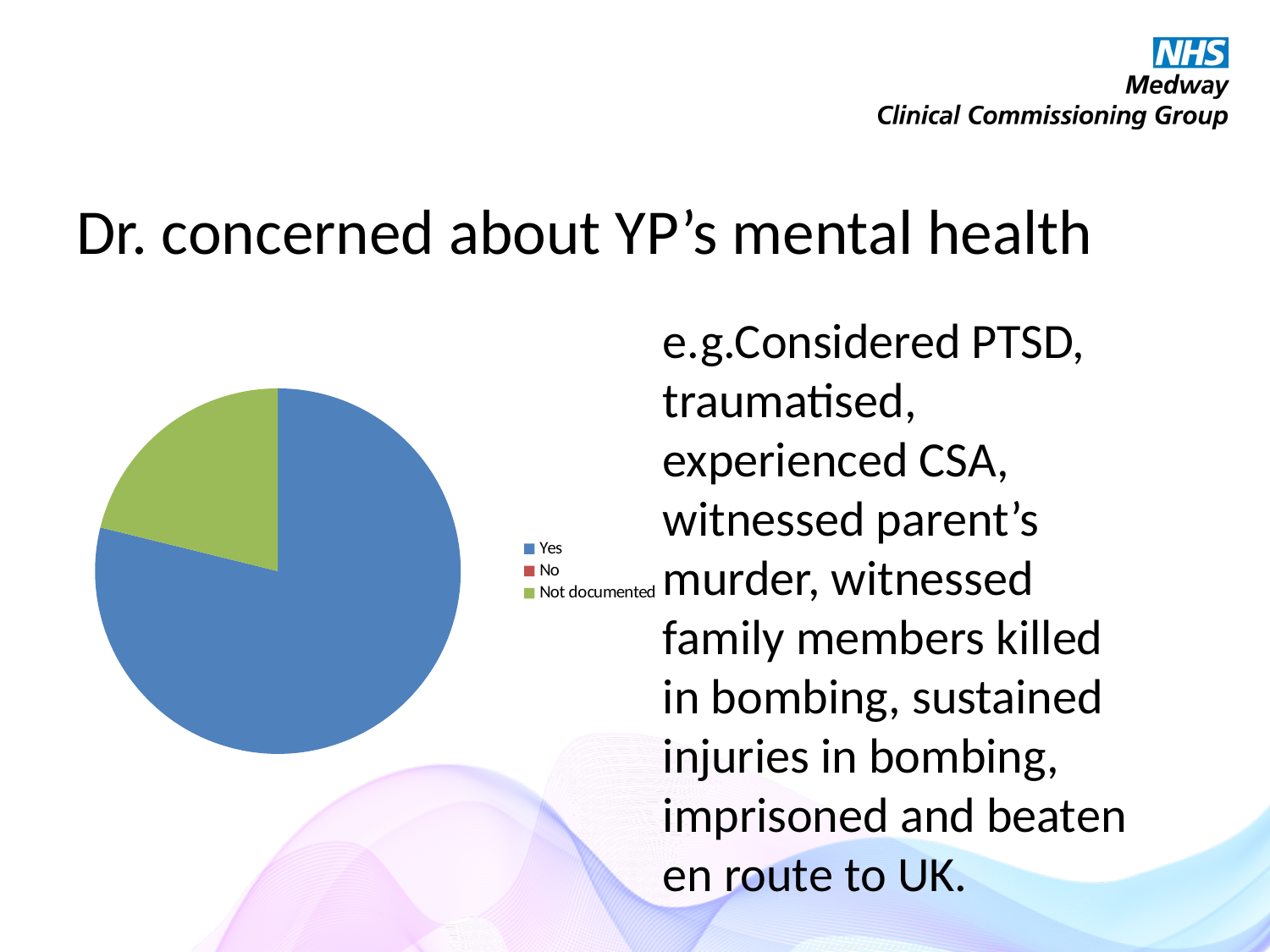
What are the legend entries of the pie chart? Yes, No, Not documented What kind of chart is shown on the slide? pie chart Which slice is larger in the pie chart, Yes or Not documented? Yes What colour is the Yes slice in the pie chart? blue Which category has the largest slice of the pie chart? Yes Does the Not documented slice take up more or less than half of the pie chart? less Does the Yes slice take up more or less than half of the pie chart? more How many entries does the legend of the pie chart list? 3